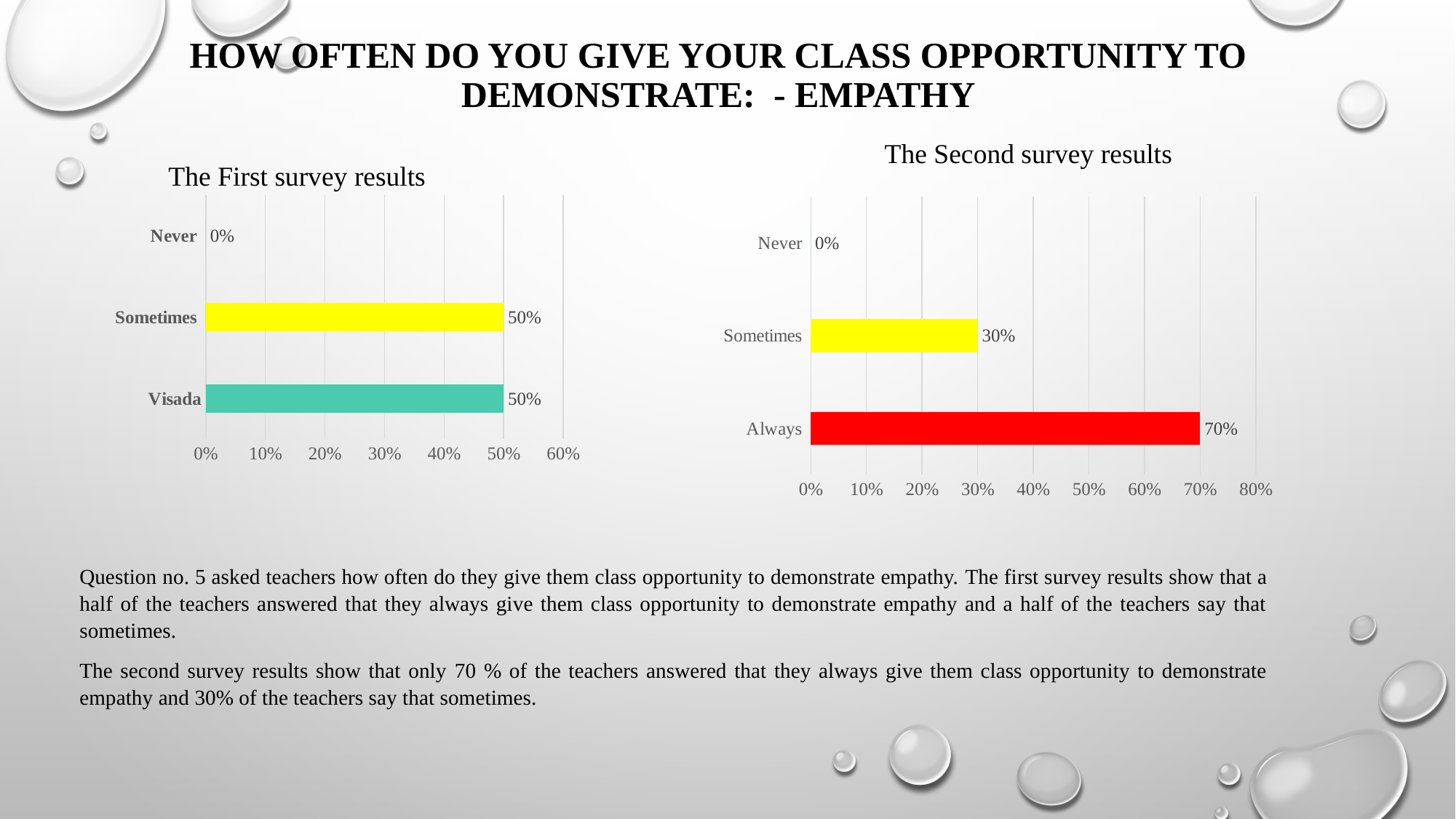
In the chart titled "The Second survey results", which is larger, the value for Always or the value for Sometimes? Always In the chart titled "The First survey results", what is the value for Never? 0% In the chart titled "The Second survey results", what colour is the bar for Always? Red In the chart titled "The Second survey results", what is the value for Always? 70% In the chart titled "The Second survey results", what is the value for Sometimes? 30% How many categories are shown in the chart titled "The First survey results"? 3 What kind of chart is "The Second survey results"? Bar chart In the chart titled "The First survey results", what is the value for Visada? 50% In the chart titled "The Second survey results", which category has the lowest value? Never In the chart titled "The First survey results", what is the value for Sometimes? 50% In the chart titled "The Second survey results", which category has the highest value? Always In the chart titled "The Second survey results", what is the difference between the values for Always and Sometimes? 40%